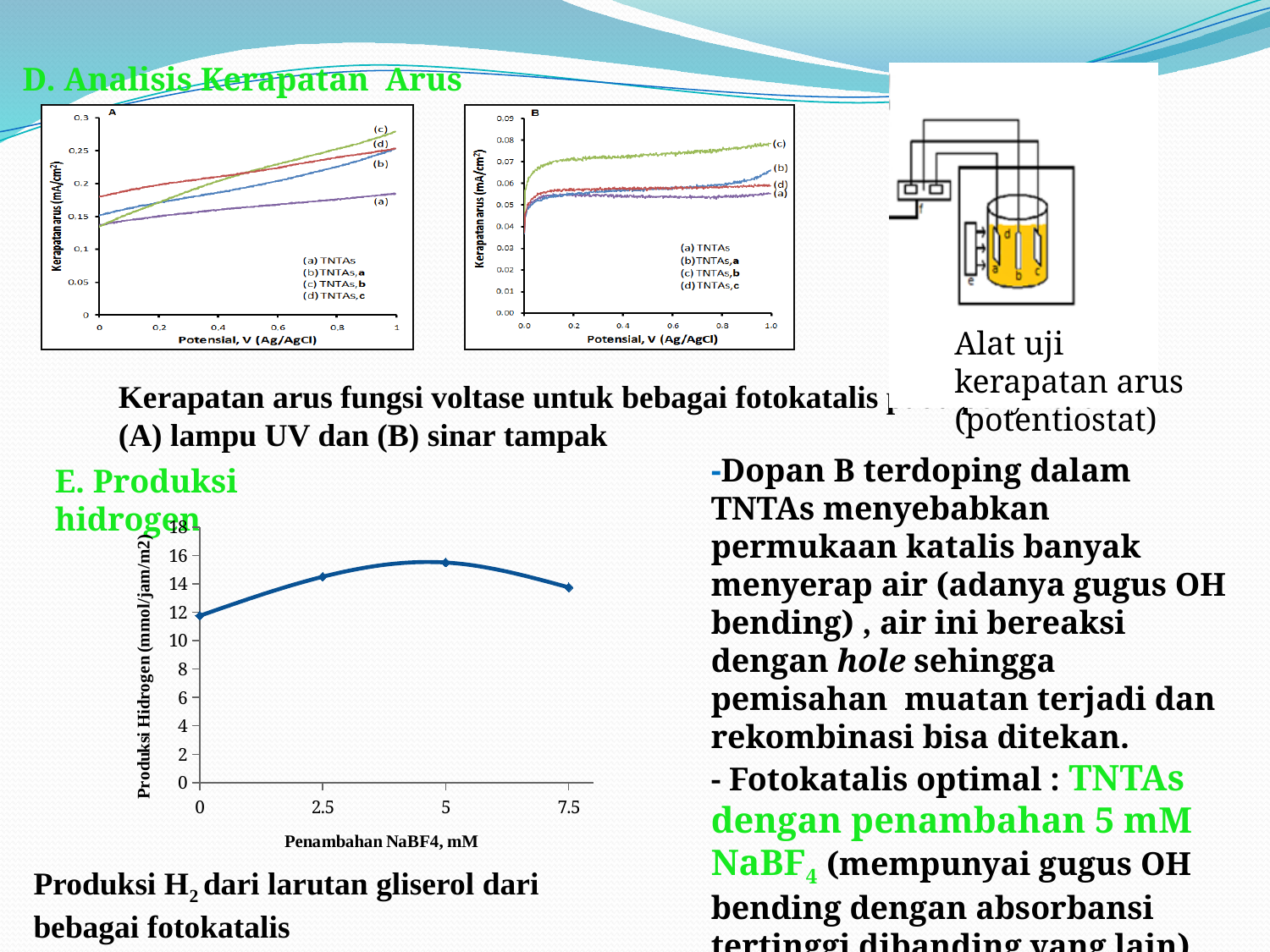
In chart A (top left), how many series does the legend list? 4 In the bottom-left chart (Produksi Hidrogen vs Penambahan NaBF4), how does hydrogen production change as NaBF4 addition increases from 0 to 7.5 mM? It rises up to 5 mM, then falls In chart A (top left), is the value for series (a) TNTAs at 1 V greater or less than 0.2? less In the bottom-left chart (Produksi Hidrogen vs Penambahan NaBF4), how many data points are plotted? 4 In the bottom-left chart (Produksi Hidrogen vs Penambahan NaBF4), which is larger: the value at 0 mM or at 5 mM? 5 mM In the bottom-left chart (Produksi Hidrogen vs Penambahan NaBF4), at which NaBF4 addition is hydrogen production highest? 5 mM What kind of chart is the bottom-left chart (Produksi Hidrogen vs Penambahan NaBF4)? Line chart In the bottom-left chart (Produksi Hidrogen vs Penambahan NaBF4), is the value at 5 mM greater or less than 14? greater In chart A (top left), which series has the highest current density at 1 V? (c) TNTAs,b In the bottom-left chart (Produksi Hidrogen vs Penambahan NaBF4), at which NaBF4 addition is hydrogen production lowest? 0 mM In chart B (top middle), which series has the highest current density across the potential range? (c) TNTAs,b In the bottom-left chart (Produksi Hidrogen vs Penambahan NaBF4), is the value at 7.5 mM greater or less than 12? greater